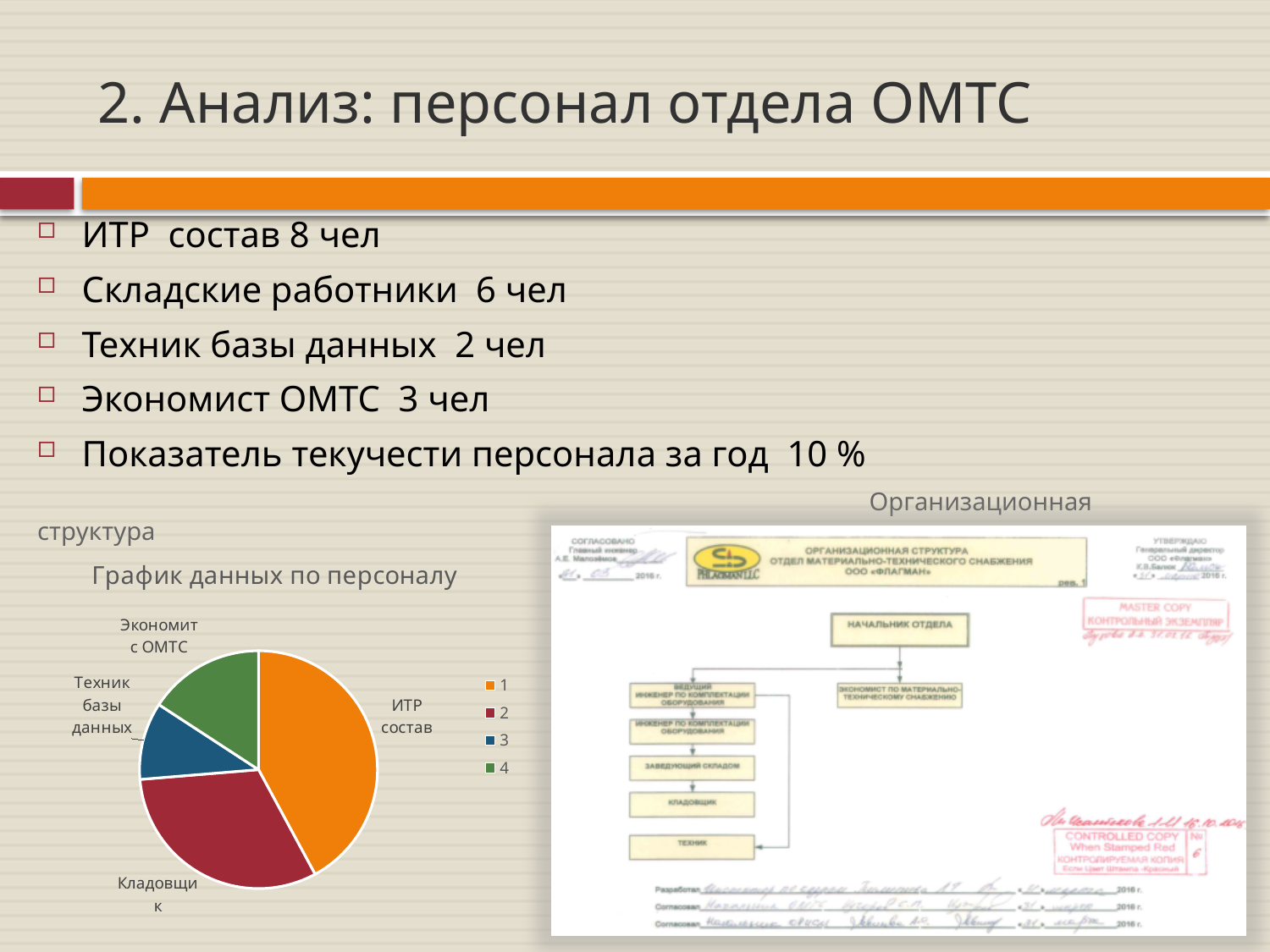
What colour is the ИТР состав slice in the pie chart? orange How many entries does the legend of the pie chart list? 4 What is the title of the chart on the slide? График данных по персоналу Which category has the largest slice in the pie chart? ИТР состав Which slice is larger in the pie chart, Кладовщик or Экономист с ОМТС? Кладовщик What kind of chart is shown on the slide? pie chart Which slice is larger in the pie chart, Экономист с ОМТС or Техник базы данных? Экономист с ОМТС Which slice is larger in the pie chart, ИТР состав or Кладовщик? ИТР состав Which category has the smallest slice in the pie chart? Техник базы данных How many slices does the pie chart have? 4